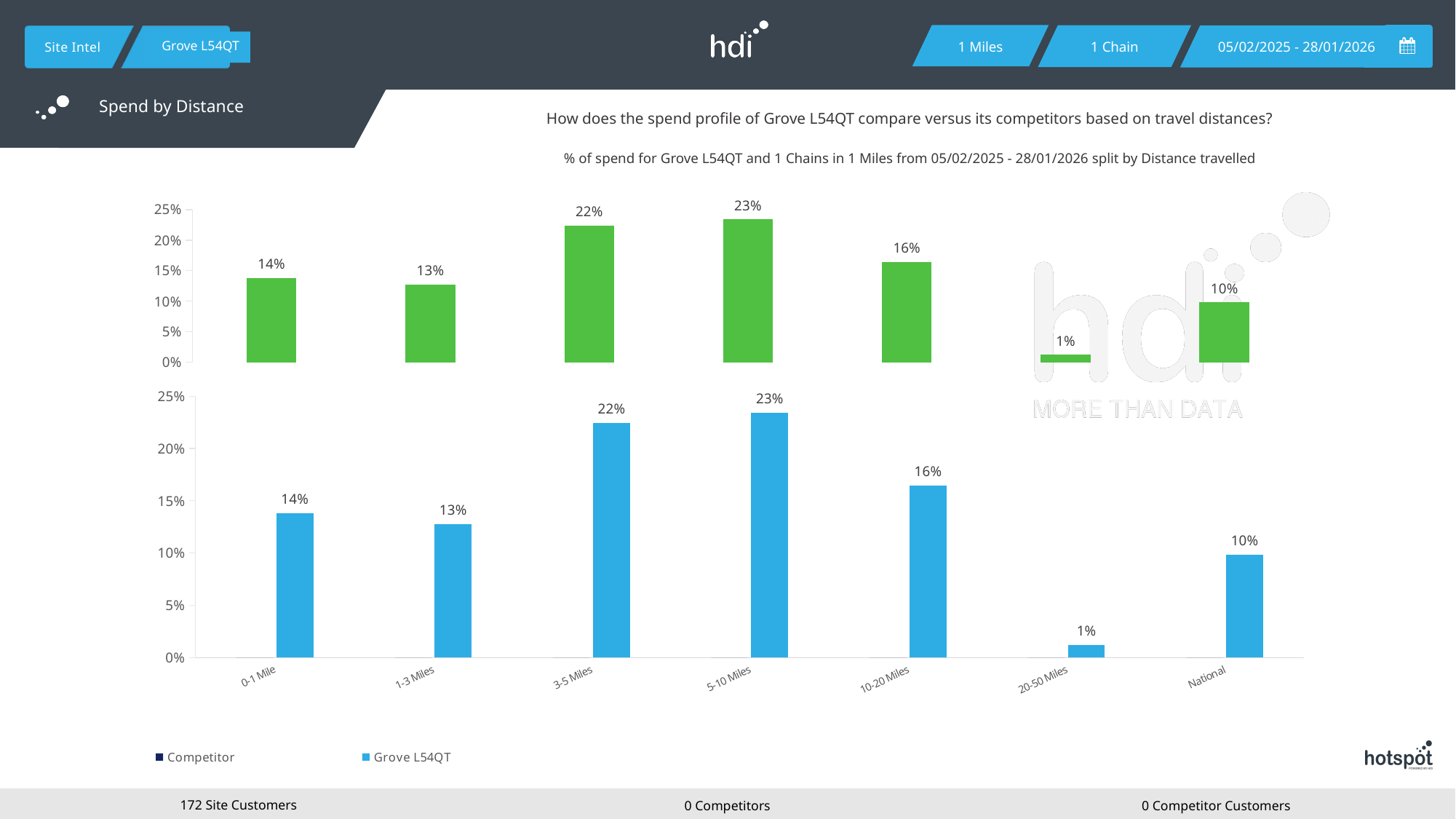
How many categories are shown on the x axis of the lower blue bar chart? 7 In the lower blue bar chart, is the value for 3-5 Miles greater or less than 20%? greater What kind of chart is the lower chart on the slide? bar chart How many series does the legend below the lower chart list? 2 In the lower blue bar chart, what is the value for National? 10% In the upper green bar chart, what is the value shown on the fourth bar from the left? 23% In the lower blue bar chart, what is the value for 5-10 Miles? 23% In the lower blue bar chart, which category has the highest value? 5-10 Miles In the lower blue bar chart, what is the difference between the values for 3-5 Miles and 1-3 Miles? 9% In the lower blue bar chart, what is the value for 0-1 Mile? 14% In the lower blue bar chart, which category has the lowest value? 20-50 Miles In the lower blue bar chart, which is larger, the value for 10-20 Miles or the value for National? 10-20 Miles